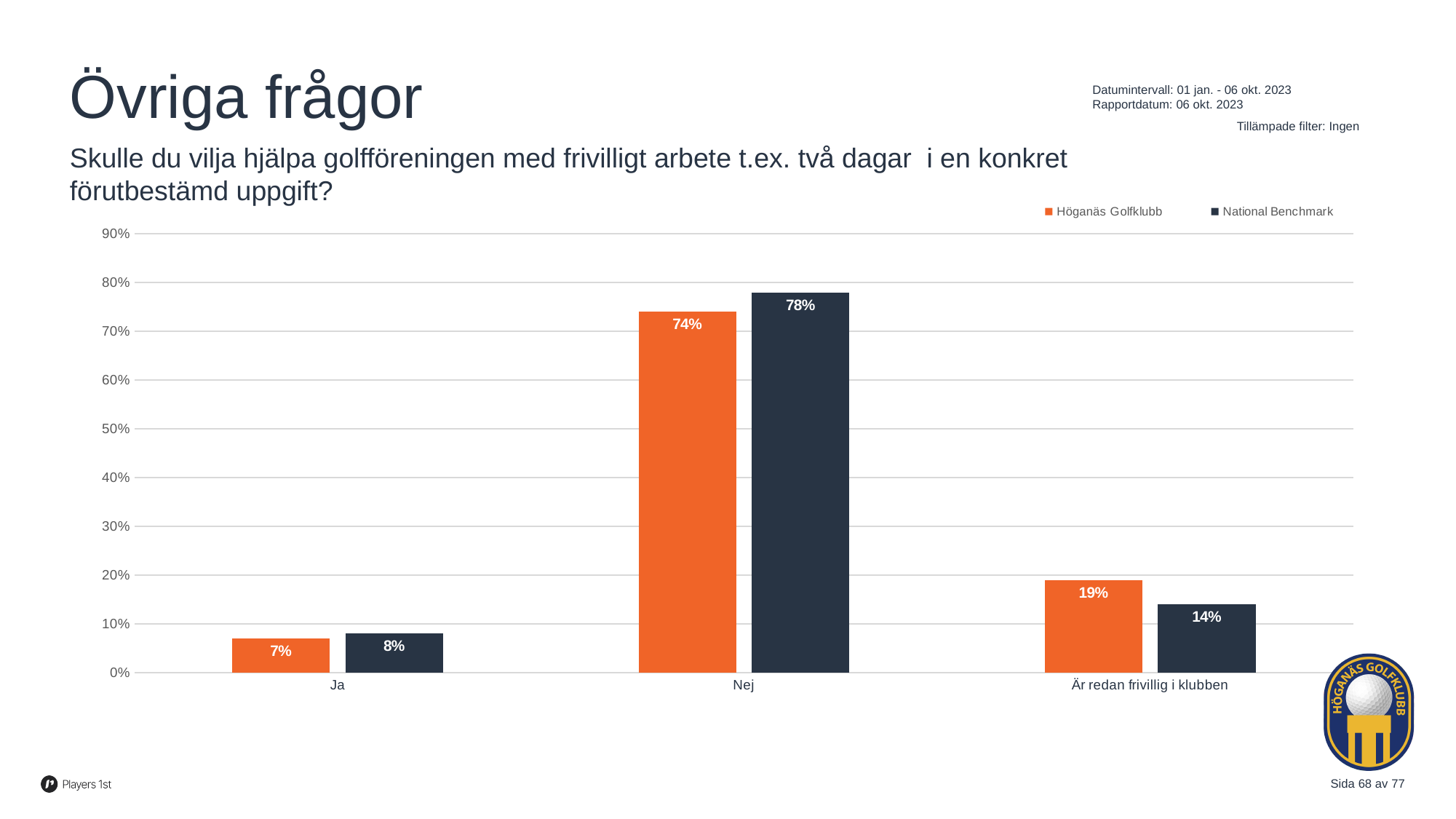
What kind of chart is shown on the slide? Bar chart Which category has the lowest value for Höganäs Golfklubb? Ja In the "Är redan frivillig i klubben" category, which series has the larger value? Höganäs Golfklubb What is the value for Höganäs Golfklubb in the "Nej" category? 74% What is the value for National Benchmark in the "Ja" category? 8% How many series does the legend list? 2 How many categories are shown on the x axis? 3 Which category has the highest value for National Benchmark? Nej What is the difference between National Benchmark and Höganäs Golfklubb in the "Nej" category? 4% What is the value for Höganäs Golfklubb in the "Är redan frivillig i klubben" category? 19% Is the value for Höganäs Golfklubb in the "Nej" category greater or less than 70%? greater Which colour represents Höganäs Golfklubb in the chart? Orange